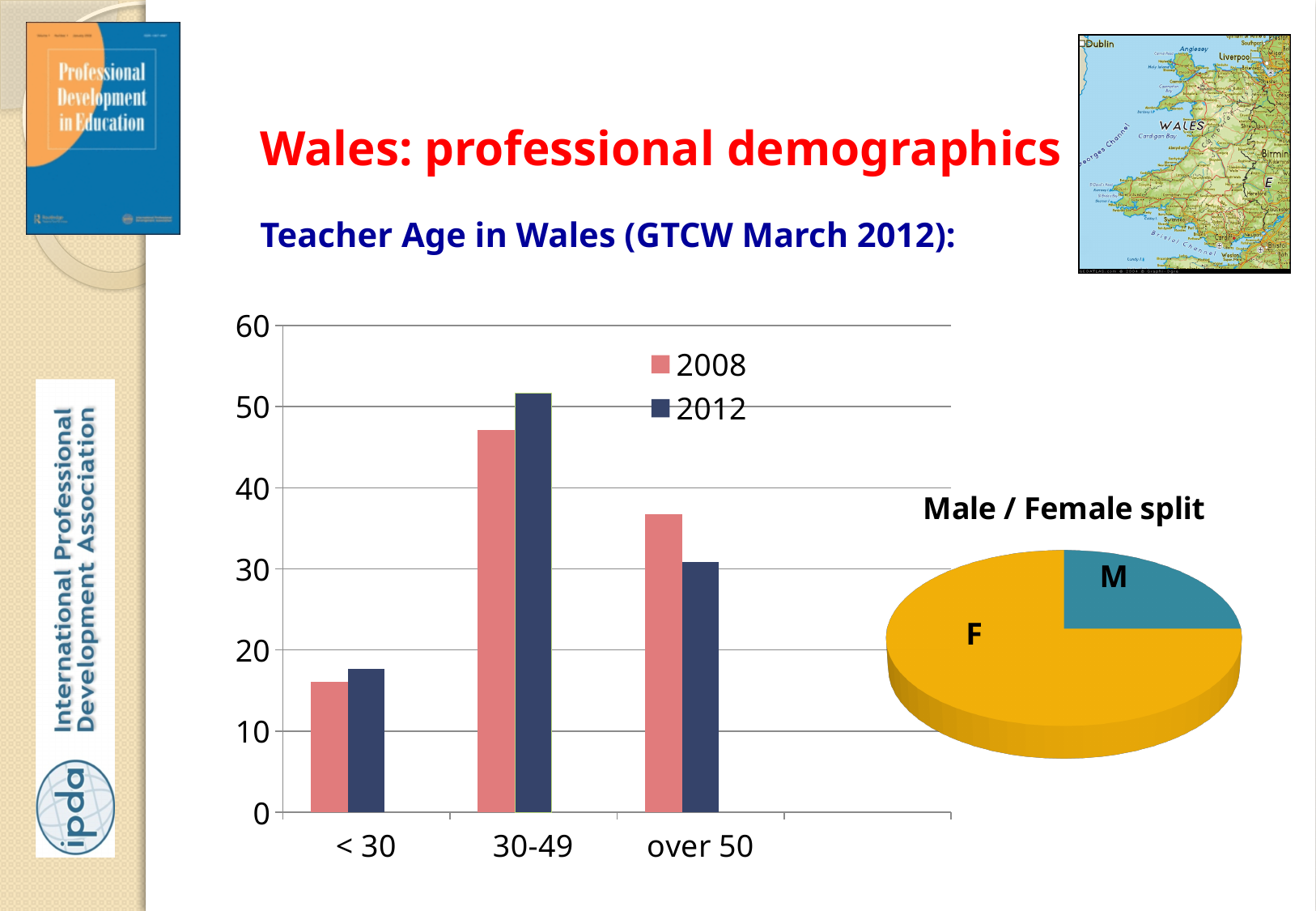
In the Teacher Age in Wales chart, which age category has the lowest value for 2008? < 30 In the Teacher Age in Wales chart, for the over 50 category, which year has the larger value, 2008 or 2012? 2008 In the Teacher Age in Wales chart, for the 30-49 category, which year has the larger value, 2008 or 2012? 2012 In the Male / Female split pie chart, which slice is larger, F or M? F What kind of chart is the Male / Female split chart? pie chart How many age categories are shown on the x axis of the Teacher Age in Wales chart? 3 What kind of chart is the Teacher Age in Wales chart? bar chart How many series does the legend of the Teacher Age in Wales chart list? 2 In the Teacher Age in Wales chart, is the 2008 value for over 50 greater or less than 30? greater In the Teacher Age in Wales chart, is the 2012 value for 30-49 greater or less than 50? greater In the Teacher Age in Wales chart, is the 2008 value for < 30 greater or less than 20? less In the Teacher Age in Wales chart, which age category has the highest value for 2012? 30-49